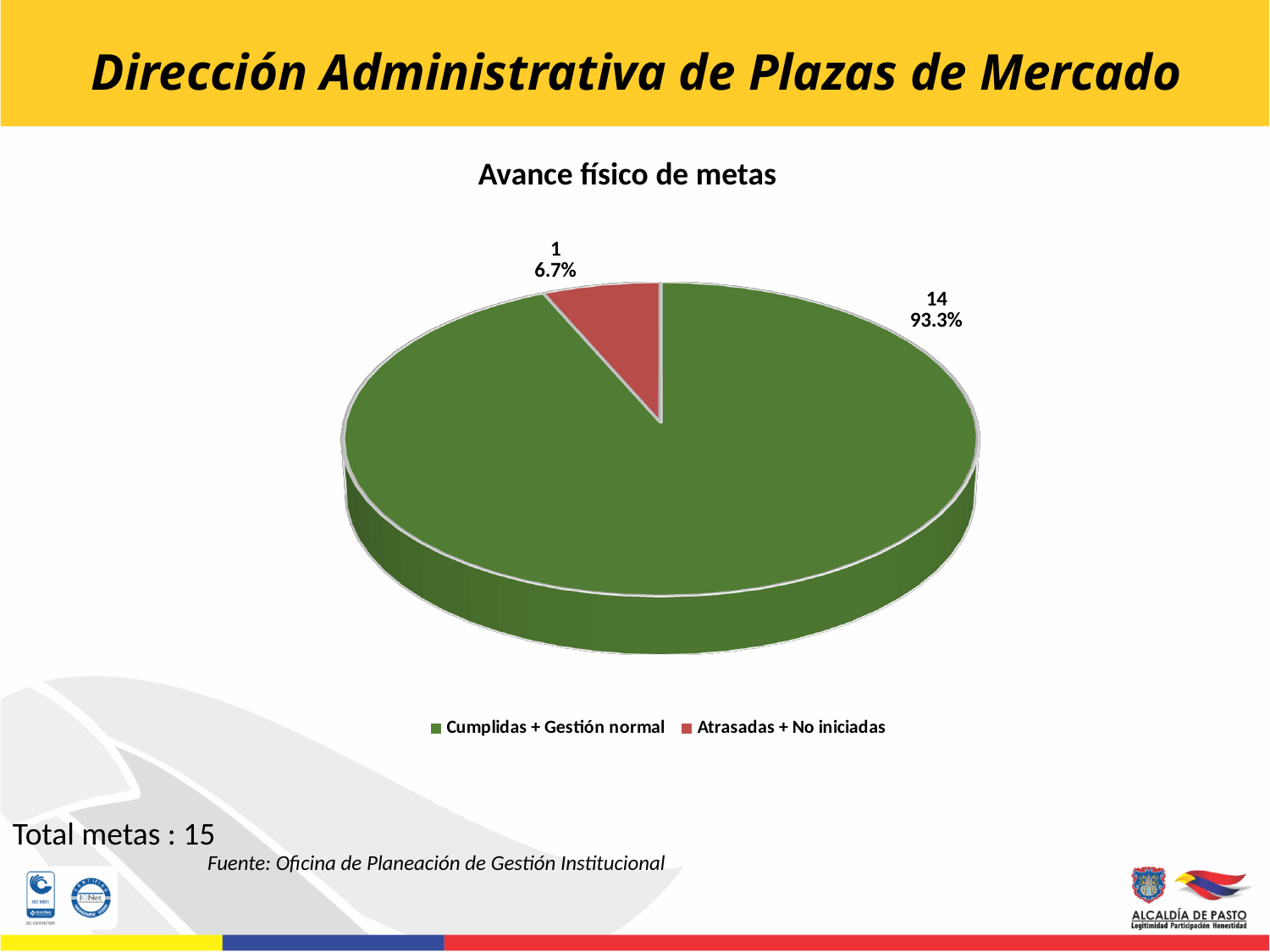
How many slices does the pie chart have? 2 Which category has the largest slice? Cumplidas + Gestión normal What kind of chart is shown on the slide? Pie chart What is the count for 'Cumplidas + Gestión normal'? 14 What is the title of the chart? Avance físico de metas How many entries does the legend list? 2 What share of the pie does 'Atrasadas + No iniciadas' represent? 6.7% What share of the pie does 'Cumplidas + Gestión normal' represent? 93.3% What is the count for 'Atrasadas + No iniciadas'? 1 Which category has the smallest slice? Atrasadas + No iniciadas Which colour represents 'Atrasadas + No iniciadas' in the chart? Red What is the difference between the counts for 'Cumplidas + Gestión normal' and 'Atrasadas + No iniciadas'? 13